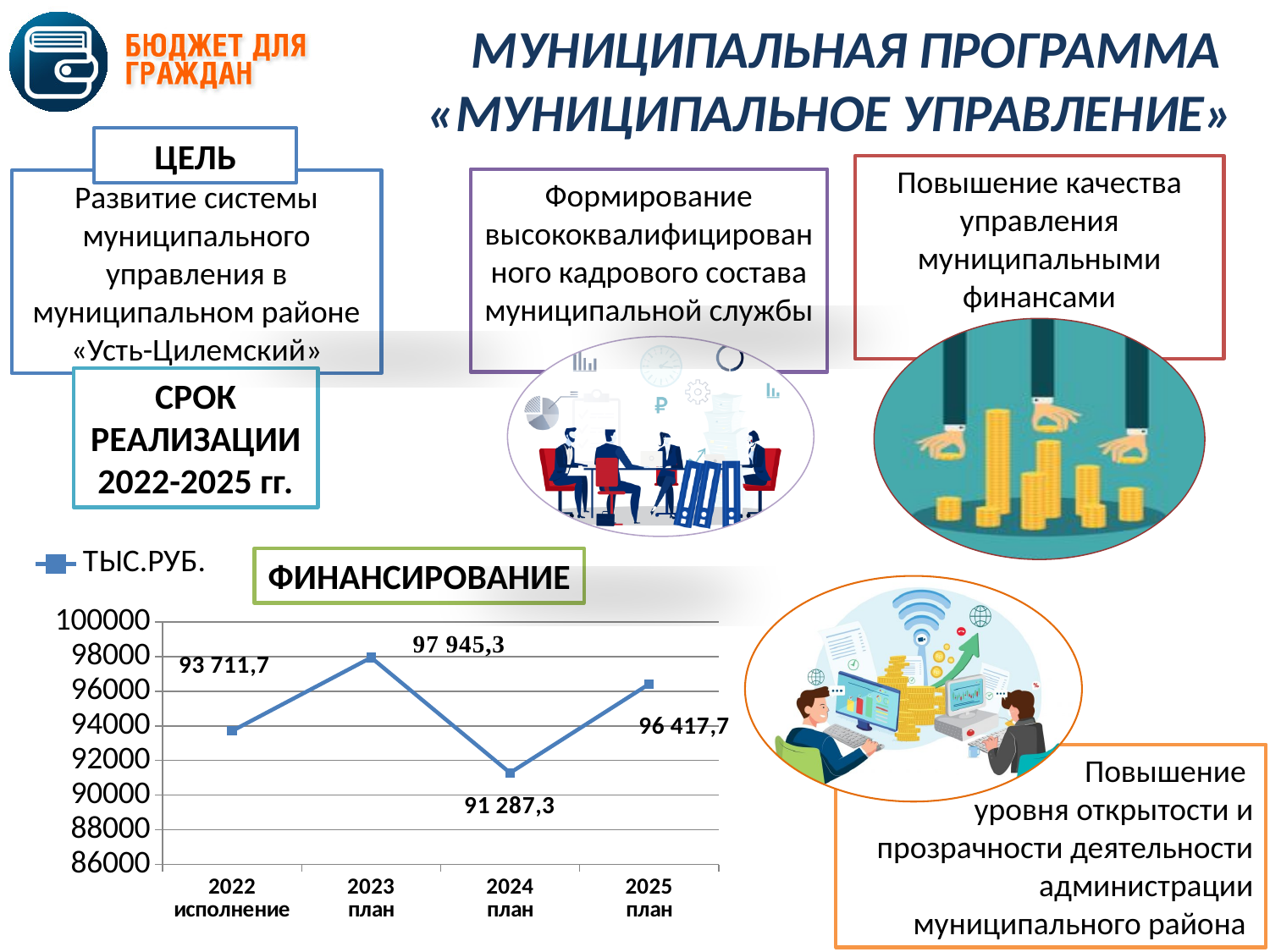
What type of chart is shown on the slide? line chart What is the value for 2025 план? 96 417,7 What is the value for 2024 план? 91 287,3 Is the value for 2024 план greater or less than 92000? less What is the legend entry of the chart? ТЫС.РУБ. Which year has the highest value? 2023 план What is the value for 2022 исполнение? 93 711,7 What is the difference between the values for 2023 план and 2024 план? 6 658,0 What is the value for 2023 план? 97 945,3 Which year has the lowest value? 2024 план Which is larger, the value for 2022 исполнение or the value for 2025 план? 2025 план How many data points are plotted on the chart? 4